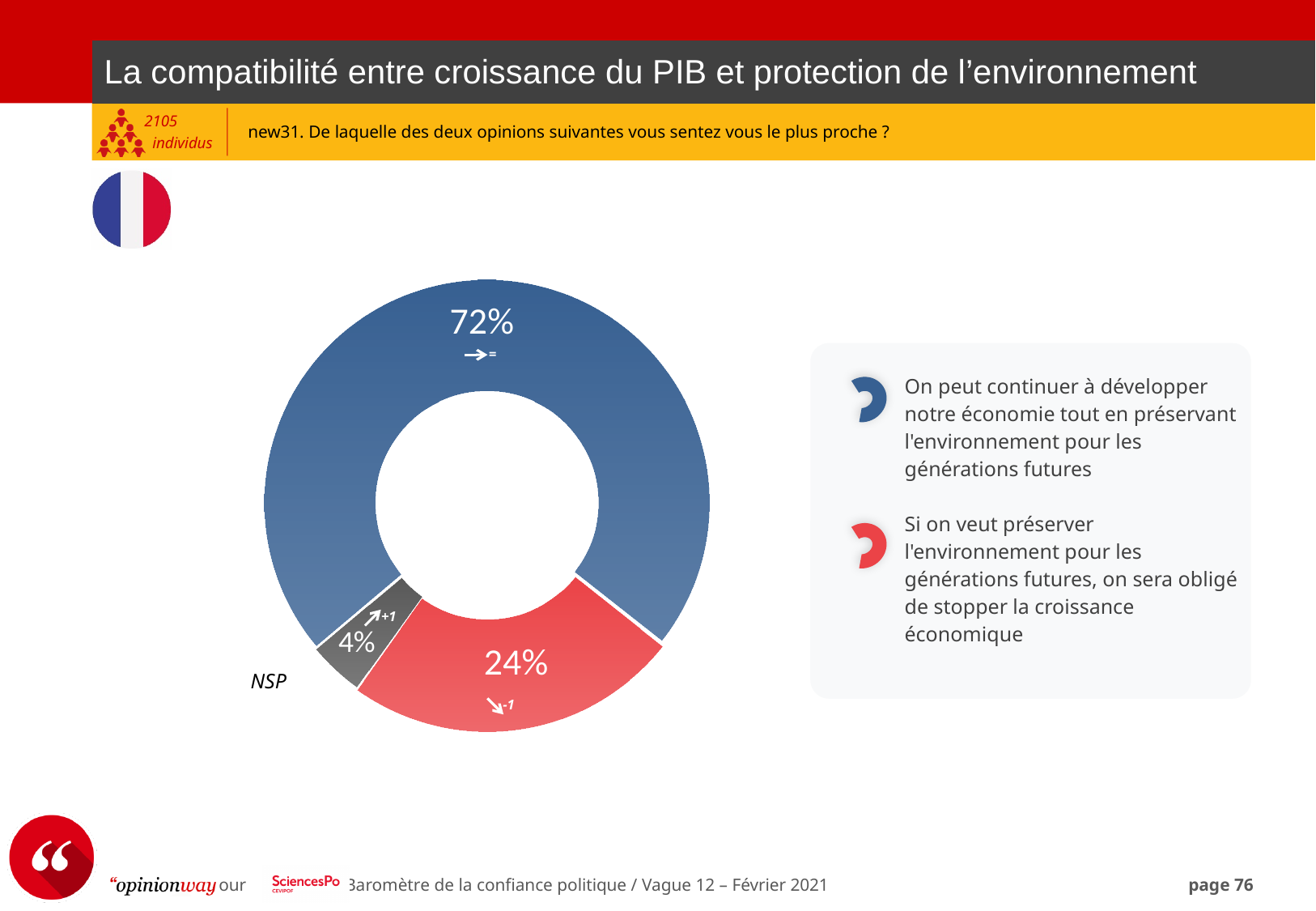
What share of respondents chose the opinion "Si on veut préserver l'environnement pour les générations futures, on sera obligé de stopper la croissance économique"? 24% Which is larger: the share for continuing to develop the economy while preserving the environment, or the share for stopping economic growth? Continuing to develop the economy while preserving the environment (72%) Which slice of the donut chart is the smallest? NSP (4%) What is the difference in percentage points between the 72% slice and the 24% slice? 48 points What colour is the slice representing the 24% opinion? Red What kind of chart is shown on the slide? Donut (pie) chart What percentage is shown for NSP? 4% How many slices does the donut chart have? 3 What share of respondents chose the opinion "On peut continuer à développer notre économie tout en préservant l'environnement pour les générations futures"? 72% Which slice of the donut chart is the largest? 72% (On peut continuer à développer notre économie tout en préservant l'environnement) What change indicator is shown next to the 24% slice? -1 What is the combined share of the two opinion slices (excluding NSP)? 96%